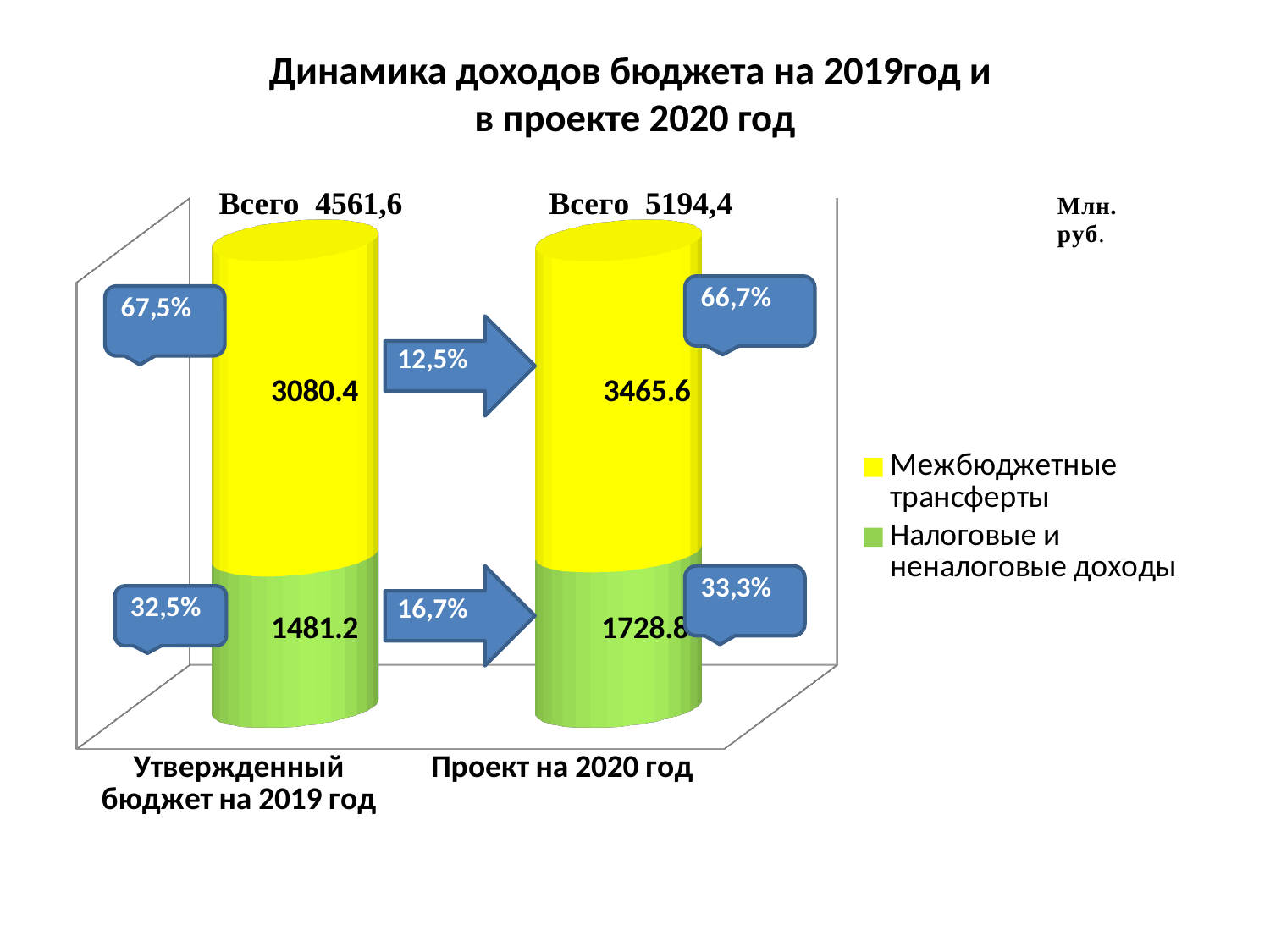
What is the total shown for Утвержденный бюджет на 2019 год? 4561,6 How many series does the legend list? 2 What is the difference between Межбюджетные трансферты for Проект на 2020 год and for Утвержденный бюджет на 2019 год? 385.2 What is the value of Налоговые и неналоговые доходы for Утвержденный бюджет на 2019 год? 1481.2 What is the total shown for Проект на 2020 год? 5194,4 What is the value of Межбюджетные трансферты for Утвержденный бюджет на 2019 год? 3080.4 How many categories are shown on the x axis? 2 What is the value of Межбюджетные трансферты for Проект на 2020 год? 3465.6 What is the value of Налоговые и неналоговые доходы for Проект на 2020 год? 1728.8 What kind of chart is shown on the slide? Stacked bar chart Which category has the higher value for Межбюджетные трансферты: Утвержденный бюджет на 2019 год or Проект на 2020 год? Проект на 2020 год Which colour represents Налоговые и неналоговые доходы in the legend? Green